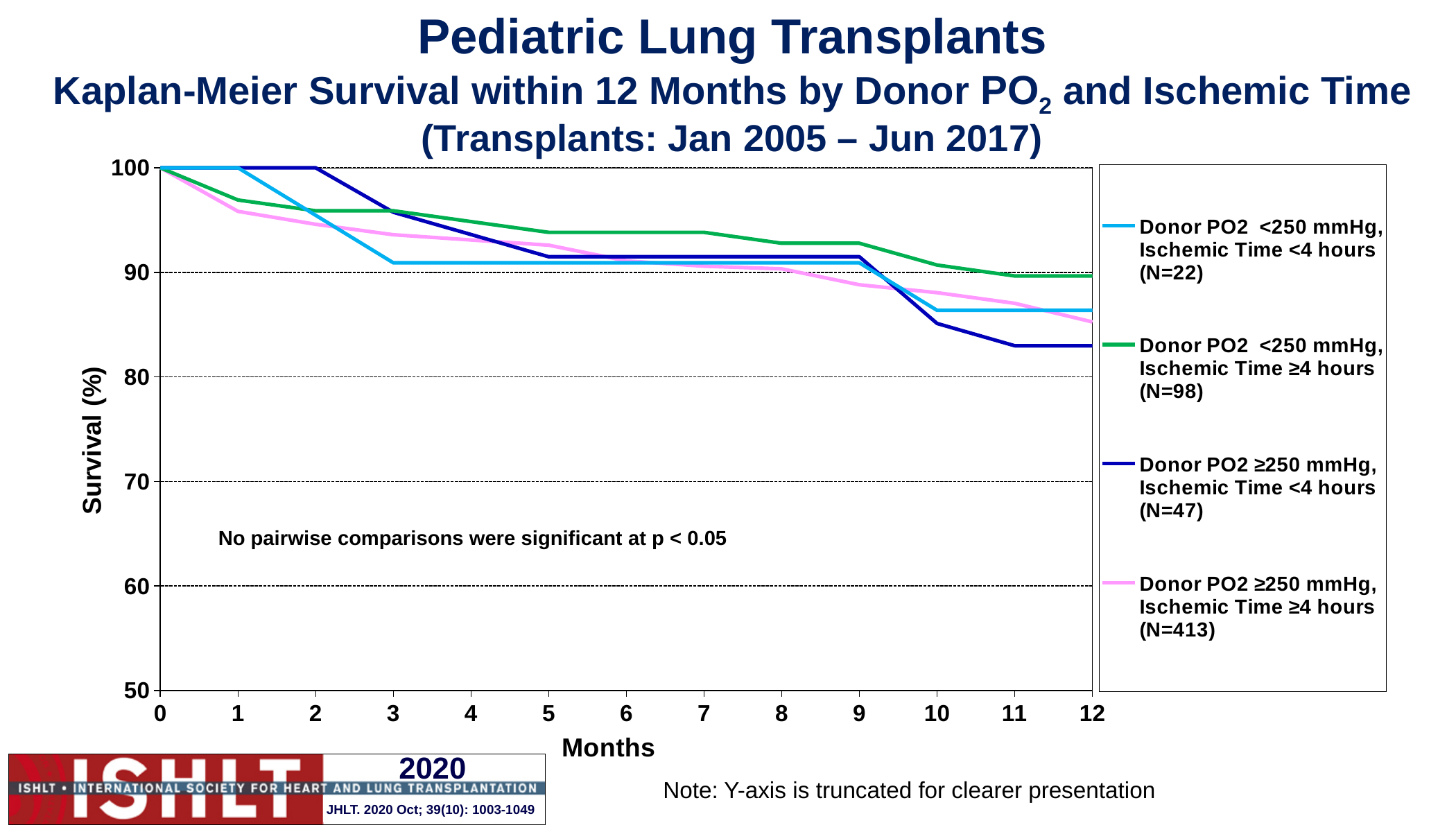
What is the survival value for all groups at month 0? 100 What is the N for the Donor PO2 ≥250 mmHg, Ischemic Time ≥4 hours group shown in the legend? N=413 Is the survival value for the Donor PO2 ≥250 mmHg, Ischemic Time <4 hours group at 12 months greater or less than 90? less What kind of chart is shown on the slide? Line chart At 12 months, which group has higher survival: Donor PO2 <250 mmHg, Ischemic Time ≥4 hours or Donor PO2 ≥250 mmHg, Ischemic Time <4 hours? Donor PO2 <250 mmHg, Ischemic Time ≥4 hours Which group has the lowest survival at 12 months? Donor PO2 ≥250 mmHg, Ischemic Time <4 hours (N=47) Which group has the highest survival at 12 months? Donor PO2 <250 mmHg, Ischemic Time ≥4 hours (N=98) What is the label of the y-axis? Survival (%) How many series does the legend list? 4 Is the survival value for the Donor PO2 <250 mmHg, Ischemic Time ≥4 hours group at 6 months greater or less than 90? greater Do the survival curves rise or fall as months increase? Fall Is the survival value for the Donor PO2 ≥250 mmHg, Ischemic Time ≥4 hours group at 12 months greater or less than 90? less